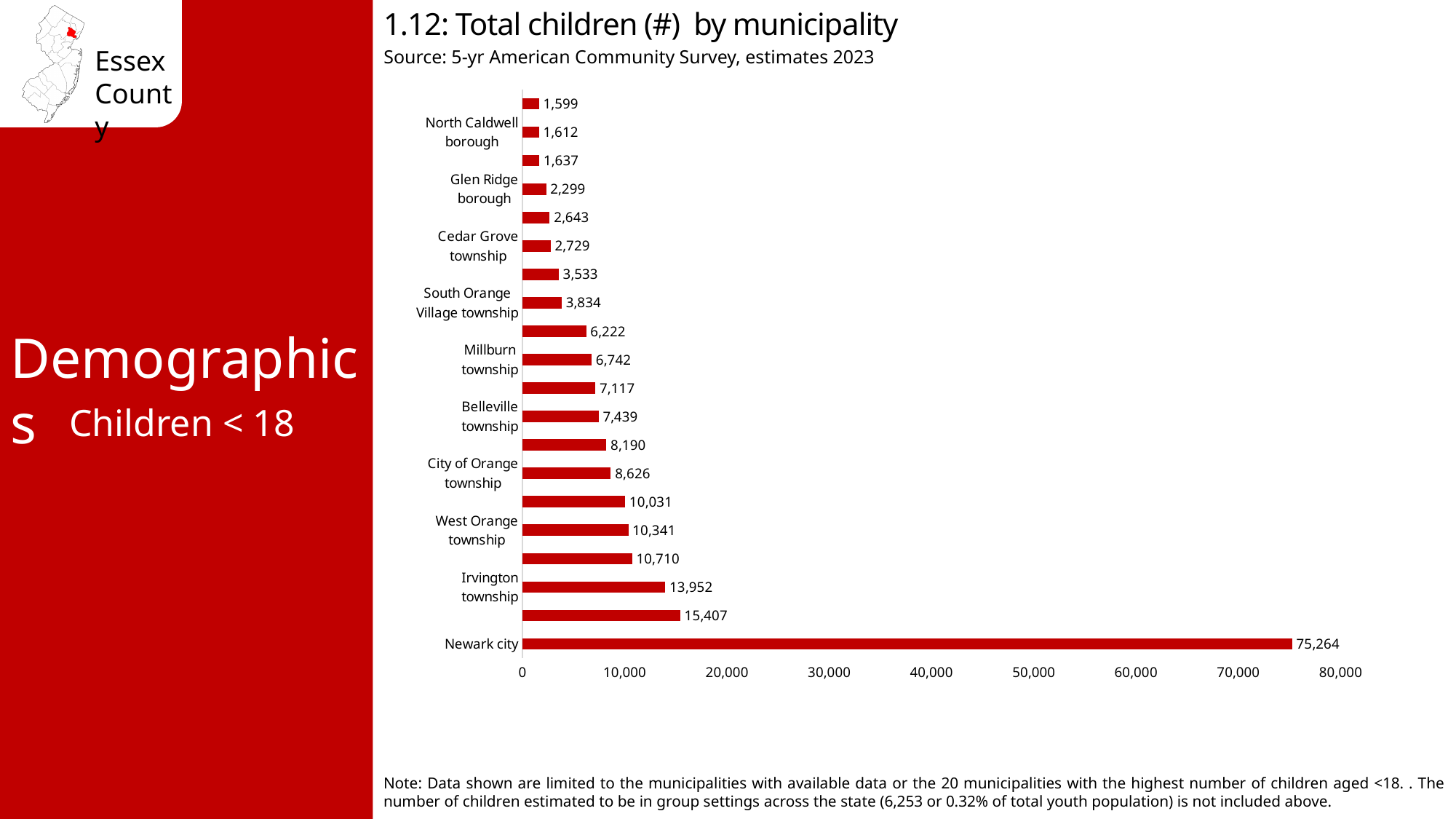
What is the total number of children for Glen Ridge borough? 2,299 What kind of chart is shown on the slide? Bar chart How many bars are shown on the chart? 20 Which has more children, West Orange township or Belleville township? West Orange township What is the difference between the values for Newark city and Irvington township? 61,312 Is the value for Newark city greater or less than 70,000? greater What is the total number of children for Irvington township? 13,952 What is the smallest value shown on the chart? 1,599 Which municipality has the highest number of children? Newark city What is the total number of children for West Orange township? 10,341 What is the total number of children for Newark city? 75,264 What is the total number of children for Belleville township? 7,439